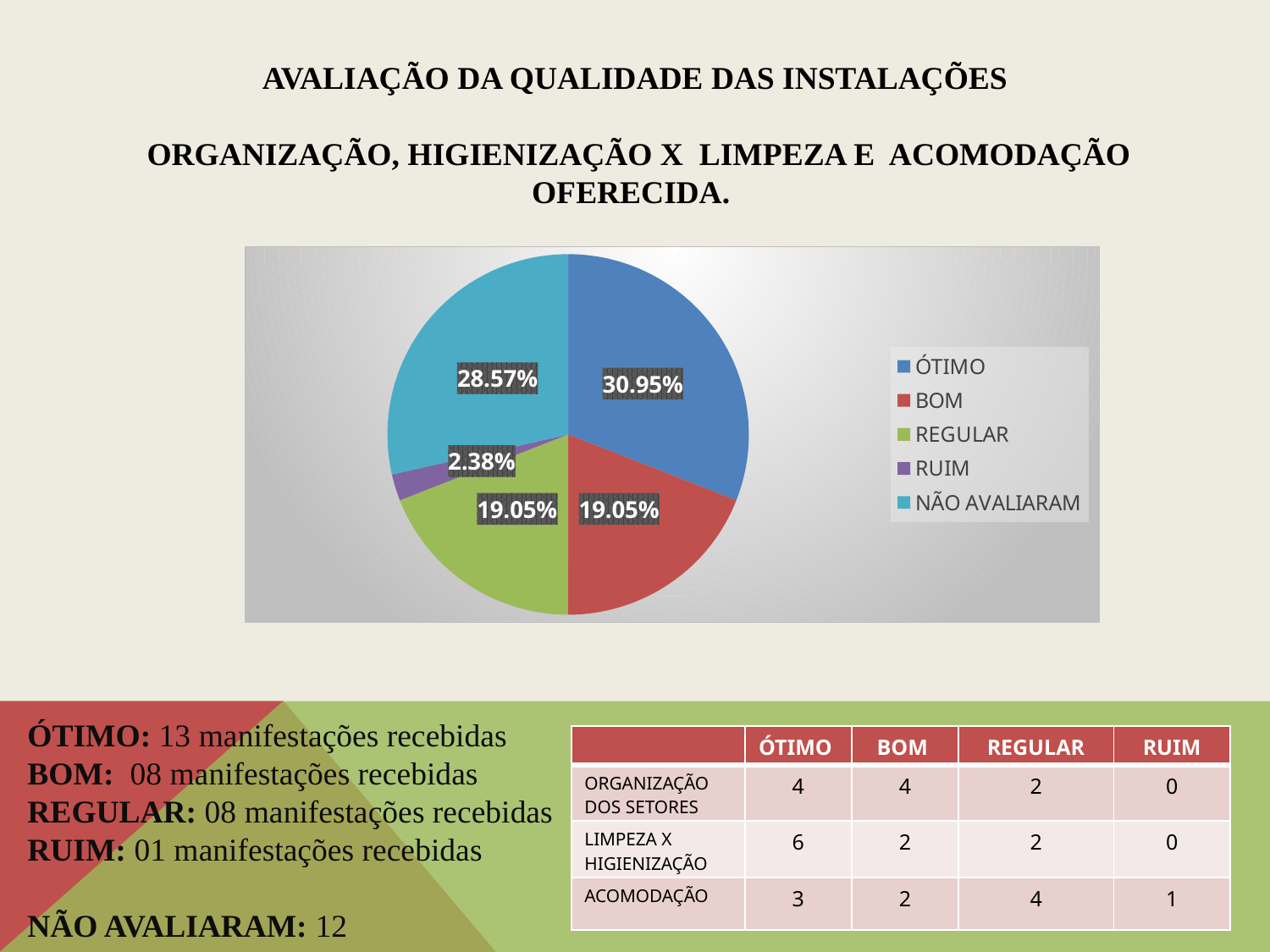
What kind of chart is shown on the slide? pie chart What share of the pie does BOM represent? 19.05% What share of the pie does NÃO AVALIARAM represent? 28.57% What share of the pie does ÓTIMO represent? 30.95% What is the difference in percentage points between the ÓTIMO slice and the BOM slice? 11.90% What is the difference in percentage points between the NÃO AVALIARAM slice and the RUIM slice? 26.19% Which category has the largest slice of the pie? ÓTIMO Which category has the smallest slice of the pie? RUIM What share of the pie does RUIM represent? 2.38% How many slices does the pie chart have? 5 Which category is shown in purple in the legend? RUIM Which slice is larger, ÓTIMO or NÃO AVALIARAM? ÓTIMO